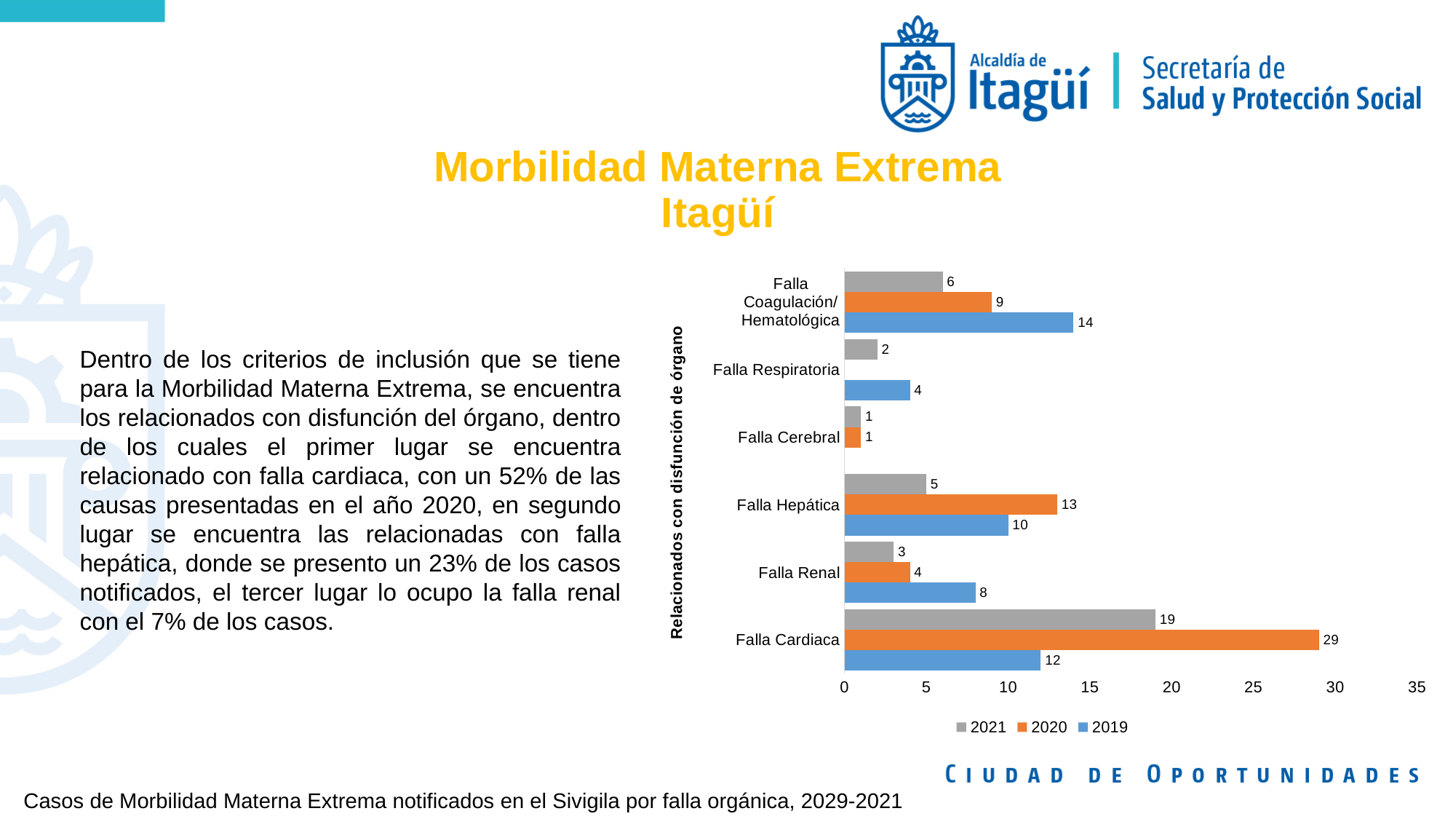
What is the value for Falla Cardiaca in 2020? 29 What kind of chart is shown on the slide? Bar chart Which category has the lowest value in the 2019 series among those with a 2019 bar? Falla Respiratoria Which is larger for Falla Hepática: the 2020 value or the 2019 value? 2020 How many categories are shown on the y axis? 6 What is the total of the three series values for Falla Renal? 15 Which category has the highest value in the 2021 series? Falla Cardiaca What is the y-axis title of the chart? Relacionados con disfunción de órgano What is the value for Falla Hepática in 2021? 5 How many series does the legend list? 3 What is the difference between the 2020 and 2019 values for Falla Cardiaca? 17 What is the value for Falla Coagulación/Hematológica in 2019? 14